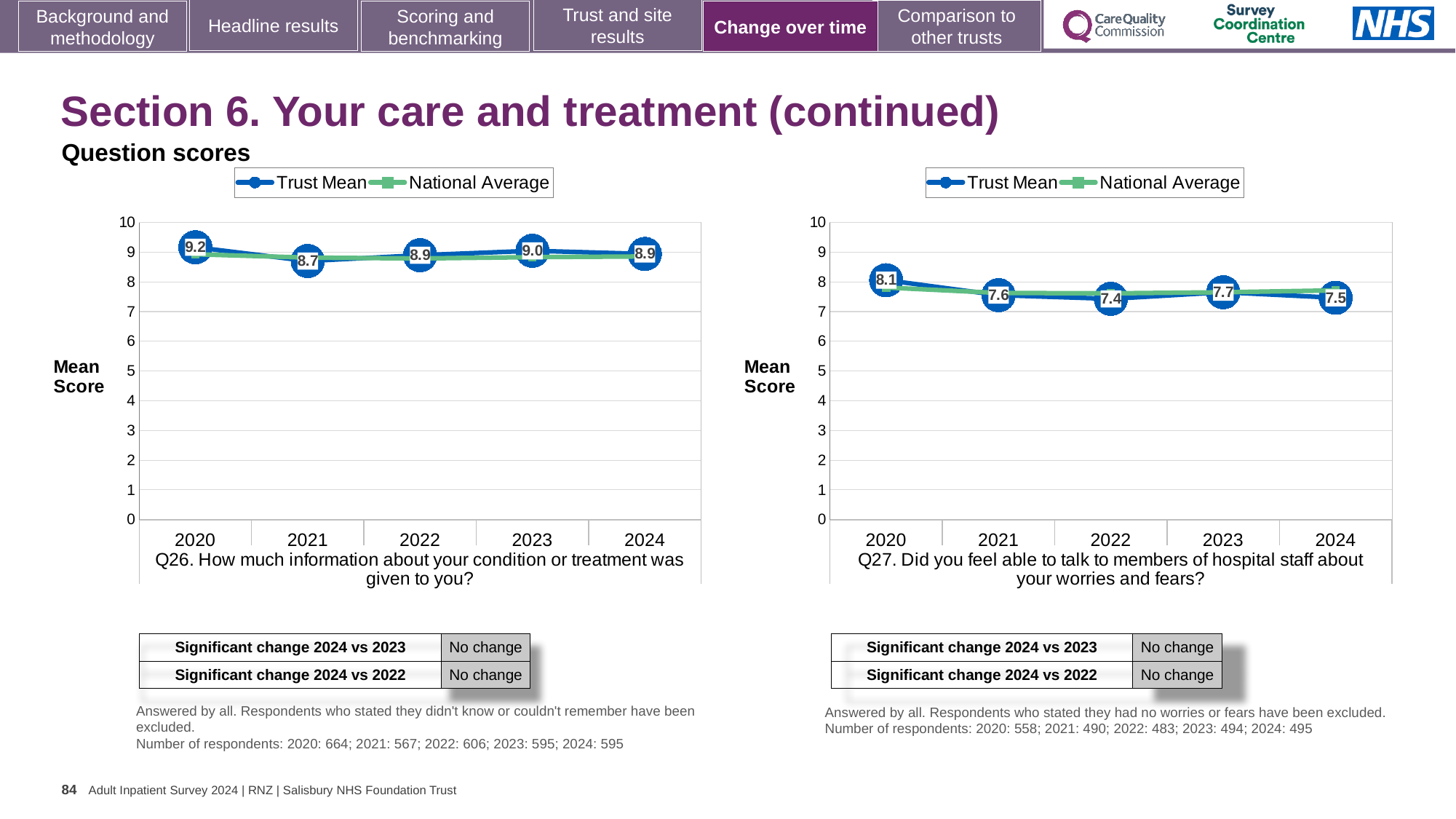
On the Q26 chart (left), which year has the highest Trust Mean score? 2020 On the Q27 chart (right), what is the Trust Mean score for 2022? 7.4 How many years are plotted on the x axis of the Q26 chart (left)? 5 What kind of chart is the Q26 chart (left)? Line chart On the Q27 chart (right), is the National Average value for 2020 greater or less than 7? greater On the Q26 chart (left), what is the difference between the Trust Mean scores for 2020 and 2021? 0.5 On the Q26 chart (left), what is the Trust Mean score for 2021? 8.7 On the Q26 chart (left), what is the Trust Mean score for 2020? 9.2 On the Q27 chart (right), what is the Trust Mean score for 2024? 7.5 On the Q27 chart (right), which is larger, the Trust Mean score for 2020 or for 2023? 2020 How many series does the legend of the Q27 chart (right) list? 2 On the Q27 chart (right), which year has the lowest Trust Mean score? 2022